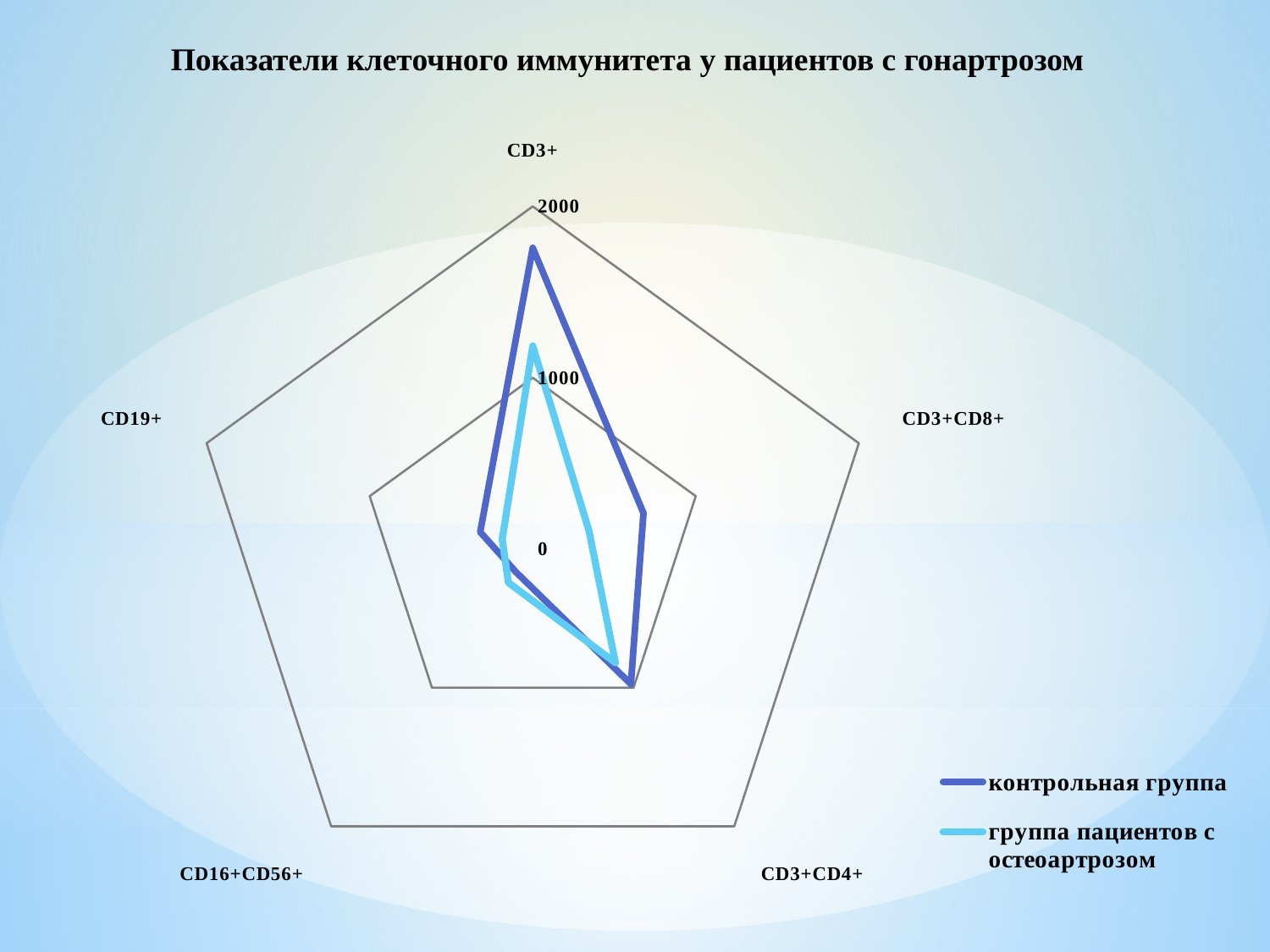
What kind of chart is shown on the slide? radar chart Is the CD3+CD8+ value for the контрольная группа greater or less than 1000? less Is the CD3+ value for the контрольная группа greater or less than 1000? greater Which category has the highest value for the контрольная группа series? CD3+ For CD3+CD8+, which series has the larger value: контрольная группа or группа пациентов с остеоартрозом? контрольная группа How many categories (axes) does the radar chart have? 5 What is the maximum value shown on the radar chart's axis scale? 2000 Is the CD19+ value for the контрольная группа greater or less than 1000? less How many series does the legend list? 2 Which category has the highest value for the группа пациентов с остеоартрозом series? CD3+ For CD3+, which series has the larger value: контрольная группа or группа пациентов с остеоартрозом? контрольная группа